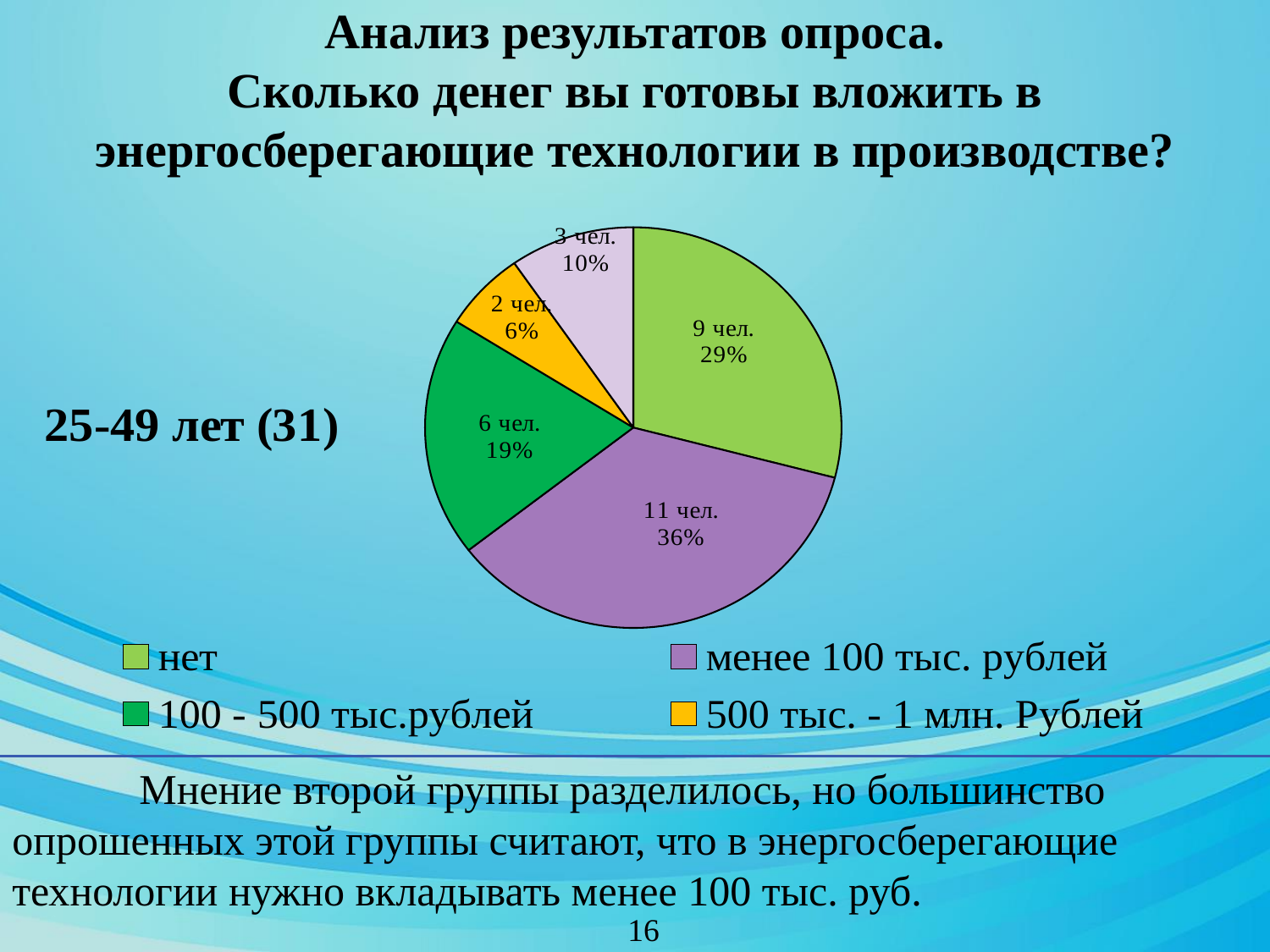
How many slices does the pie chart have? 5 How many people chose "менее 100 тыс. рублей"? 11 чел. What share of the pie does the "нет" slice represent? 29% How many people chose "500 тыс. - 1 млн. Рублей"? 2 чел. What share of the pie does the "100 - 500 тыс.рублей" slice represent? 19% By how many percentage points does the "менее 100 тыс. рублей" share exceed the "нет" share? 7 How many more people chose "нет" than "100 - 500 тыс.рублей"? 3 чел. Which has more respondents: "нет" or "100 - 500 тыс.рублей"? нет Which answer option has the largest slice of the pie? менее 100 тыс. рублей How many entries does the legend list? 4 Which answer option has the smallest slice of the pie? 500 тыс. - 1 млн. Рублей What kind of chart is shown on the slide? pie chart